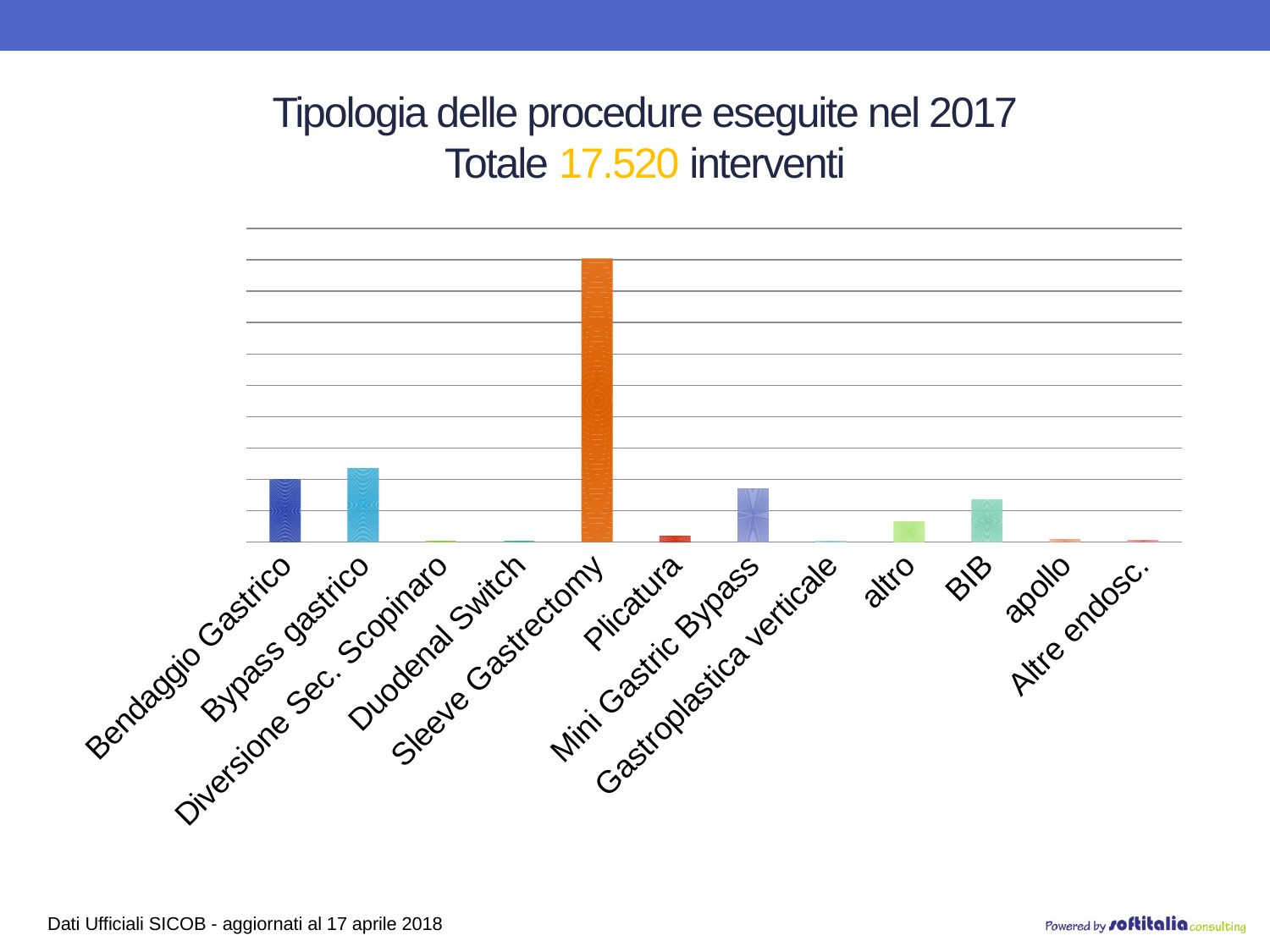
Which is larger, the bar for Bendaggio Gastrico or the bar for Plicatura? Bendaggio Gastrico Which is larger, the bar for Mini Gastric Bypass or the bar for altro? Mini Gastric Bypass What total number of interventions is stated in the chart title? 17.520 How many procedure categories are shown on the x axis? 12 What kind of chart is shown on the slide? bar chart Which year do the procedures in the chart refer to, according to the title? 2017 Which is larger, the bar for Mini Gastric Bypass or the bar for Plicatura? Mini Gastric Bypass Which procedure has the highest bar in the chart? Sleeve Gastrectomy